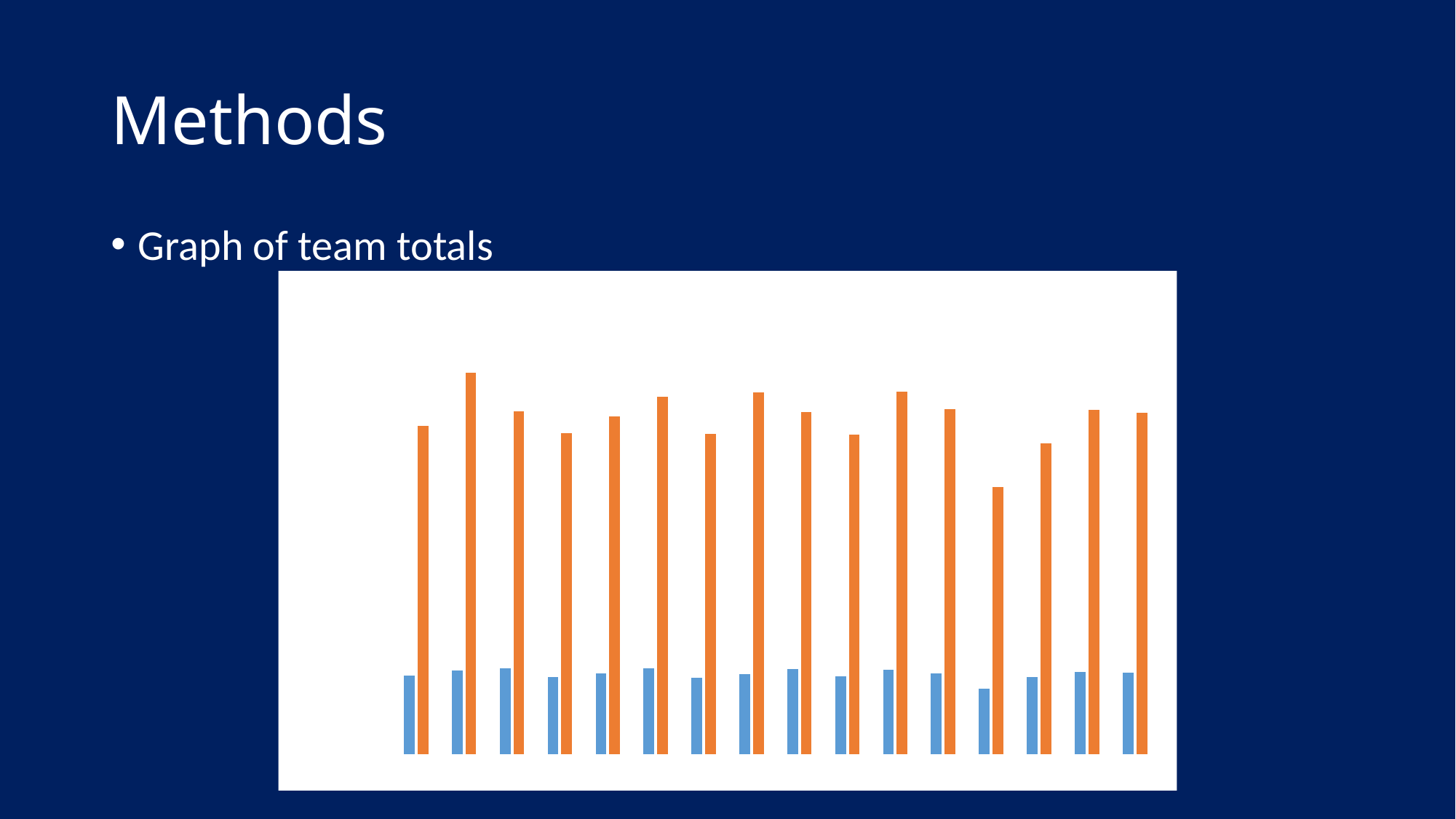
What kind of chart is shown on the slide? Bar chart Counting from the right, which group contains the shortest orange bar? The fourth group Which two colours are used for the bars in the chart? Blue and orange How many data series (distinct bar colours) are plotted in the chart? 2 In each group, are the orange bars taller or shorter than the blue bars? Taller How many groups of bars (categories) are plotted in the chart? 16 Counting from the left, which group contains the tallest orange bar? The second group Does the chart display a legend or axis labels? No Counting from the right, which group contains the shortest blue bar? The fourth group